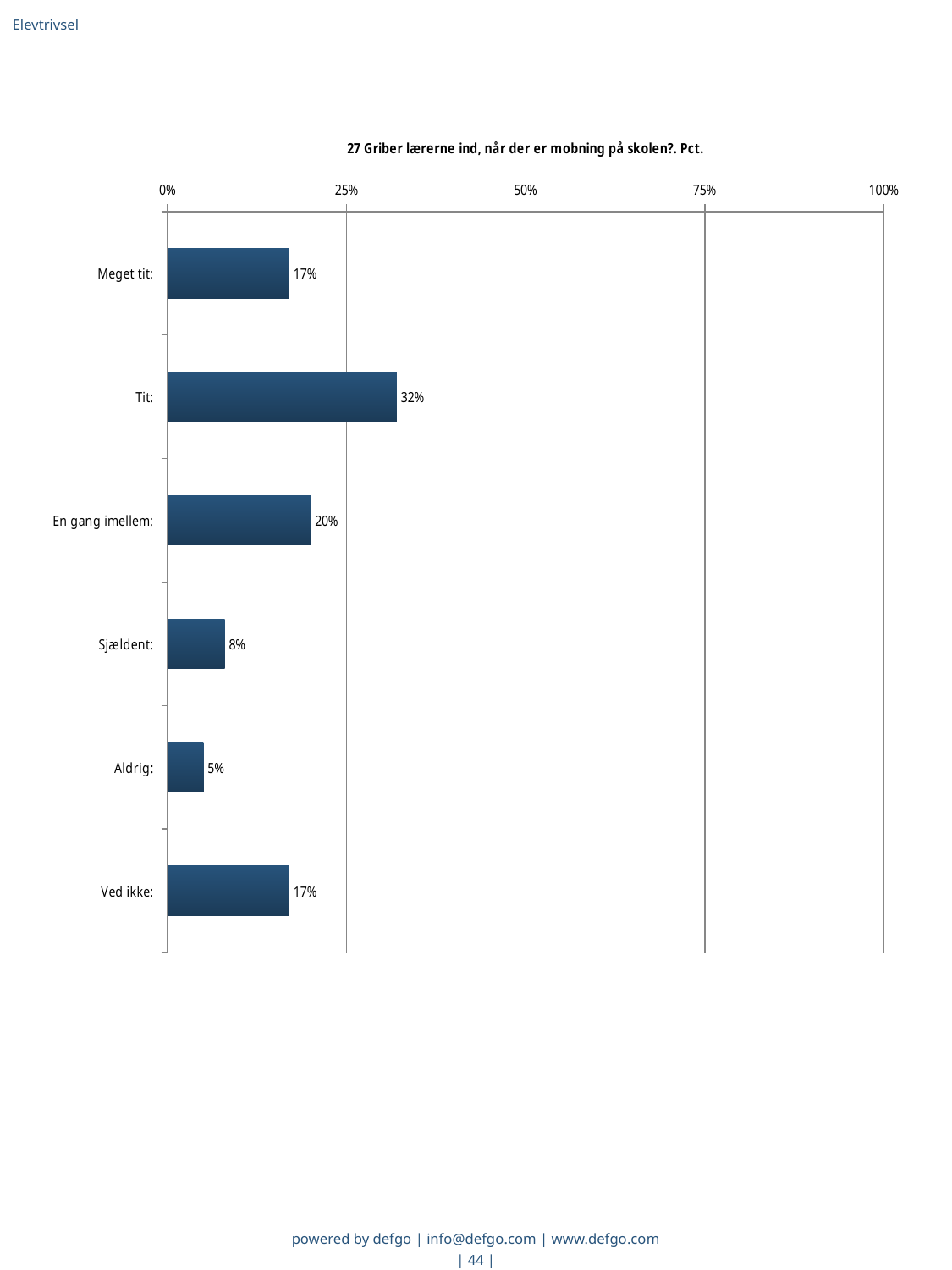
Which is larger, the value for "Meget tit:" or the value for "Sjældent:"? Meget tit: What is the value for "Tit:"? 32% What kind of chart is shown on the slide? Bar chart What is the title of the chart? 27 Griber lærerne ind, når der er mobning på skolen?. Pct. Is the value for "Tit:" greater or less than 25%? greater What is the value for "Aldrig:"? 5% What is the difference between the values for "Tit:" and "En gang imellem:"? 12% Which category has the highest value? Tit: How many categories are shown in the chart? 6 What is the value for "En gang imellem:"? 20% What is the value for "Sjældent:"? 8% Which category has the lowest value? Aldrig: